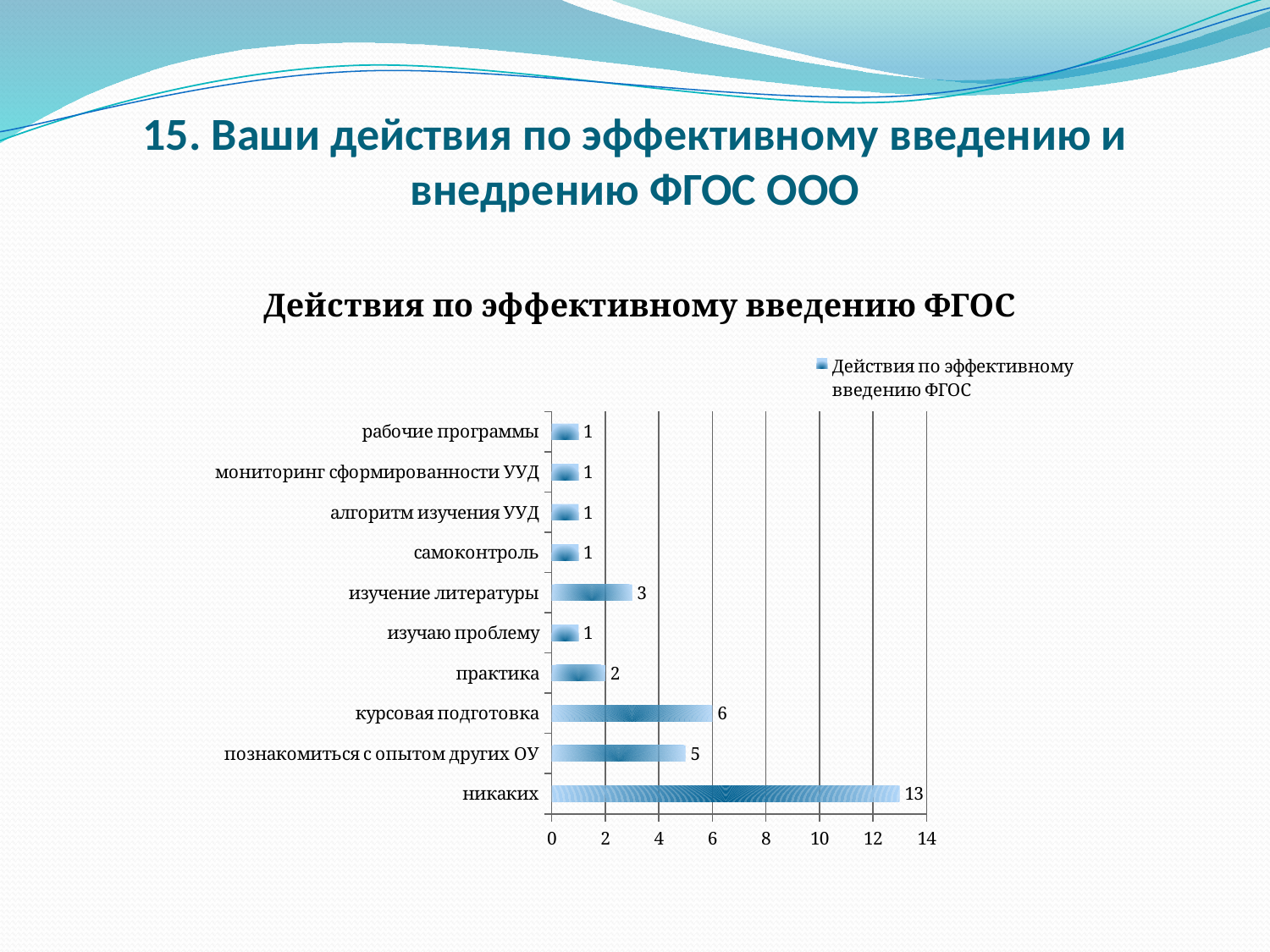
Which is larger, the value for "курсовая подготовка" or the value for "познакомиться с опытом других ОУ"? курсовая подготовка How many categories are shown in the chart? 10 What is the title of the chart? Действия по эффективному введению ФГОС What is the value for "изучение литературы"? 3 What is the value for "познакомиться с опытом других ОУ"? 5 Which category has the highest value? никаких What is the value for "курсовая подготовка"? 6 What kind of chart is shown on the slide? bar chart What is the value for "практика"? 2 What is the value for "никаких"? 13 Is the value for "никаких" greater or less than 12? greater What is the difference between the values for "никаких" and "курсовая подготовка"? 7